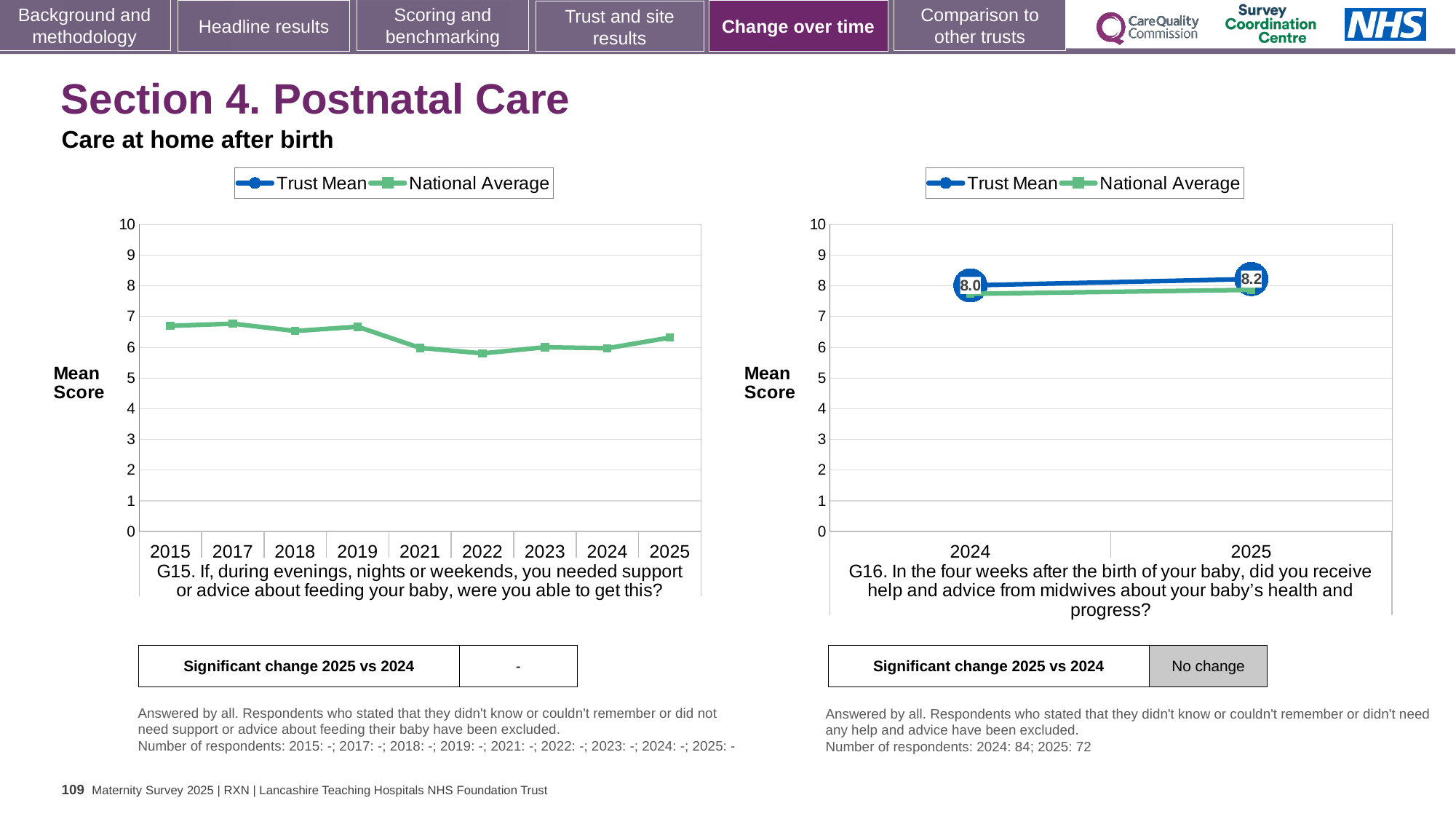
In the right chart (G16), what is the Trust Mean for 2025? 8.2 In the right chart (G16), is the National Average value for 2024 greater or less than 8? less In the left chart (G15), is the National Average value for 2019 greater or less than 7? less How many series does the legend of the left chart (G15) list? 2 In the right chart (G16), what is the difference between the Trust Mean for 2025 and 2024? 0.2 What does the 'Significant change 2025 vs 2024' box under the right chart (G16) say? No change In the left chart (G15), is the National Average value for 2015 greater or less than 6? greater In the right chart (G16), which year has the higher Trust Mean, 2024 or 2025? 2025 In the right chart (G16), what is the Trust Mean for 2024? 8.0 What kind of chart is the left chart (G15)? line chart How many years are shown on the x axis of the left chart (G15)? 9 In the left chart (G15), does the National Average rise or fall between 2015 and 2022? fall